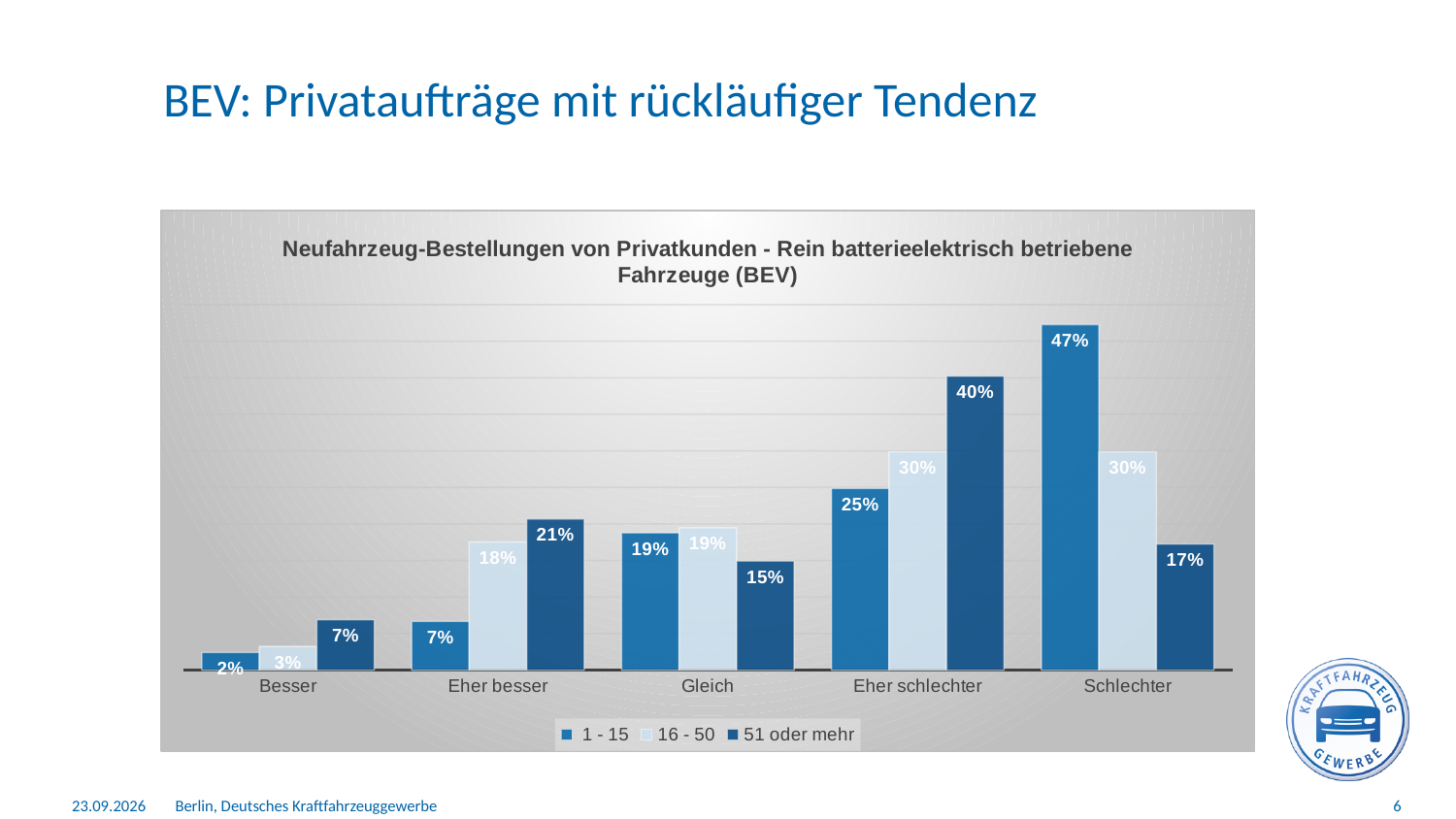
Which category has the lowest value for the '16 - 50' series? Besser In the 'Eher schlechter' category, which is larger: the '1 - 15' value or the '51 oder mehr' value? 51 oder mehr What is the difference between the '1 - 15' and '51 oder mehr' values in the 'Schlechter' category? 30% How many categories are shown on the x axis? 5 What is the value for '1 - 15' in the 'Schlechter' category? 47% What is the title of the chart? Neufahrzeug-Bestellungen von Privatkunden - Rein batterieelektrisch betriebene Fahrzeuge (BEV) Which category has the highest value for the '1 - 15' series? Schlechter How many series does the legend list? 3 What is the value for '16 - 50' in the 'Eher besser' category? 18% What is the value for '51 oder mehr' in the 'Eher schlechter' category? 40% What is the value for '51 oder mehr' in the 'Gleich' category? 15% What kind of chart is shown on the slide? Bar chart